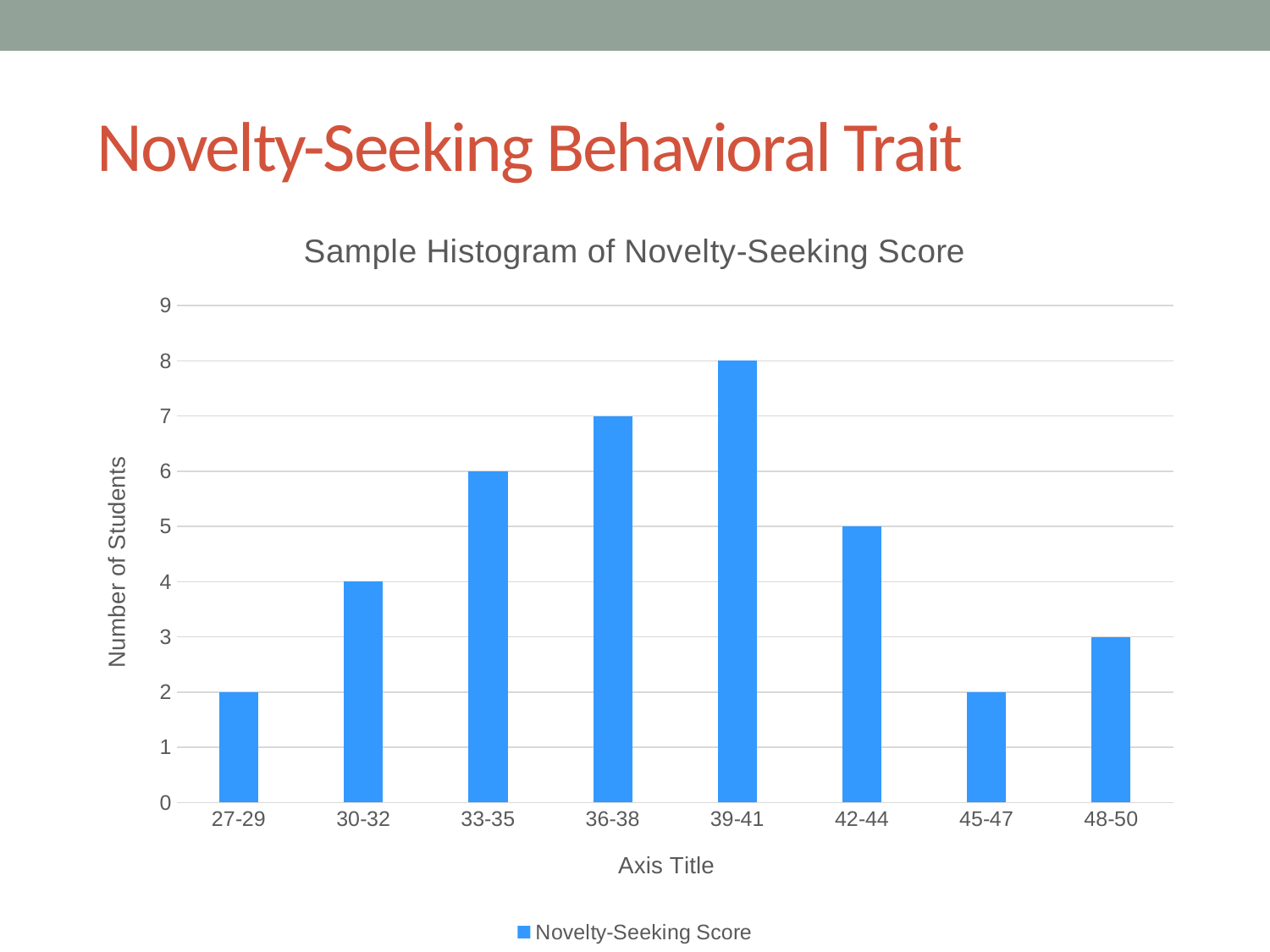
Do the values rise or fall from the 27-29 range to the 39-41 range? rise What is the number of students in the 39-41 score range? 8 Is the value for the 42-44 score range greater or less than 4? greater What is the number of students in the 33-35 score range? 6 Which score range has the highest number of students? 39-41 What is the title of the chart? Sample Histogram of Novelty-Seeking Score What kind of chart is shown on the slide? bar chart What is the difference in number of students between the 39-41 and 42-44 score ranges? 3 How many series does the legend list? 1 What is the number of students in the 48-50 score range? 3 How many score ranges are shown on the x axis? 8 Which has more students, the 30-32 range or the 36-38 range? 36-38